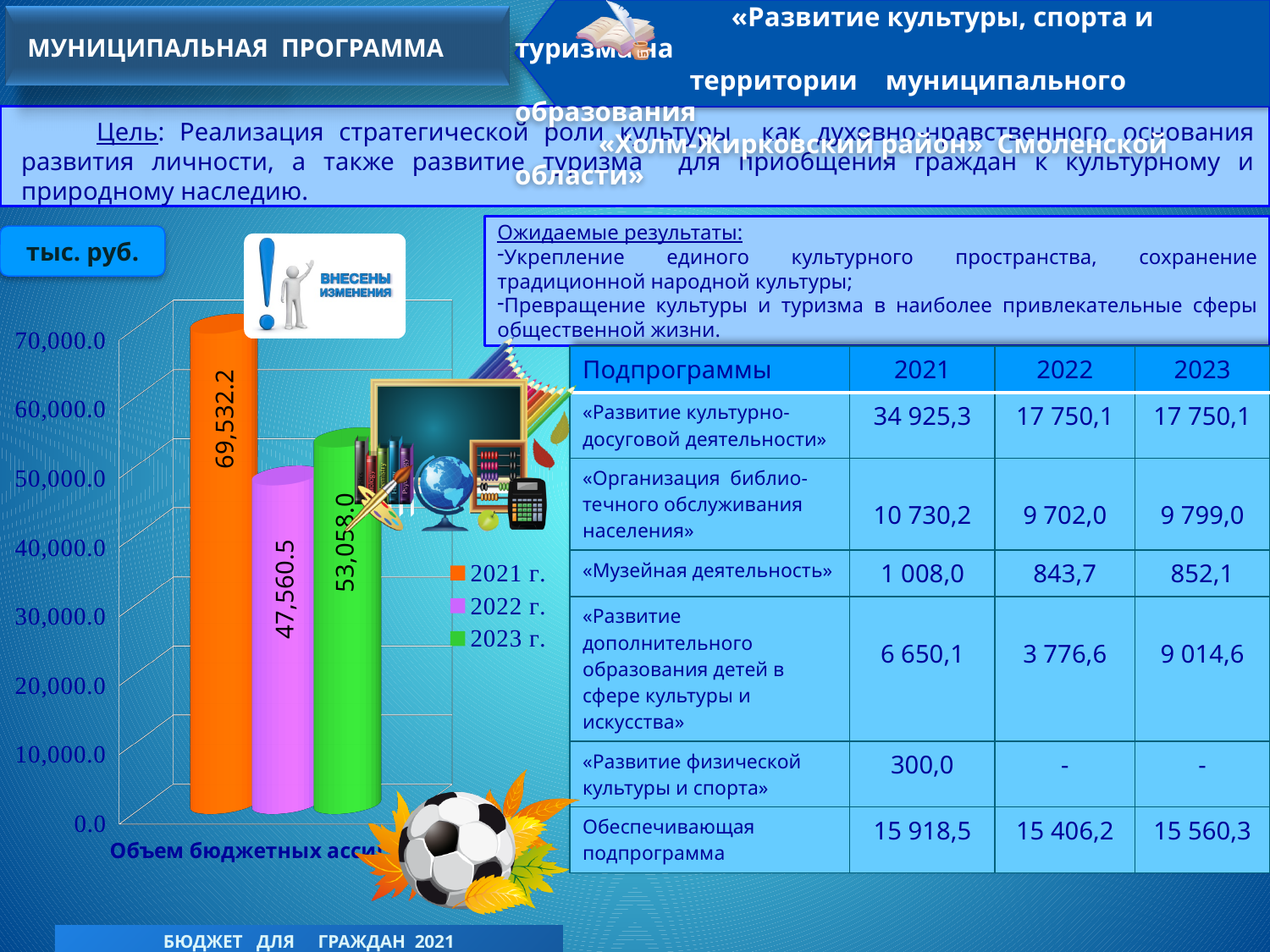
Which is larger, the value for 2022 г. or the value for 2023 г.? 2023 г. What is the difference between the values for 2021 г. and 2022 г.? 21,971.7 How many series does the chart legend list? 3 What is the value of the bar for 2022 г.? 47,560.5 What kind of chart is shown on the slide? bar chart What is the value of the bar for 2021 г.? 69,532.2 Which year has the lowest bar? 2022 г. What is the value of the bar for 2023 г.? 53,058.0 What is the difference between the values for 2023 г. and 2022 г.? 5,497.5 What colour is the bar for 2021 г.? orange Is the value for 2022 г. greater or less than 50,000.0? less Which year has the highest bar? 2021 г.